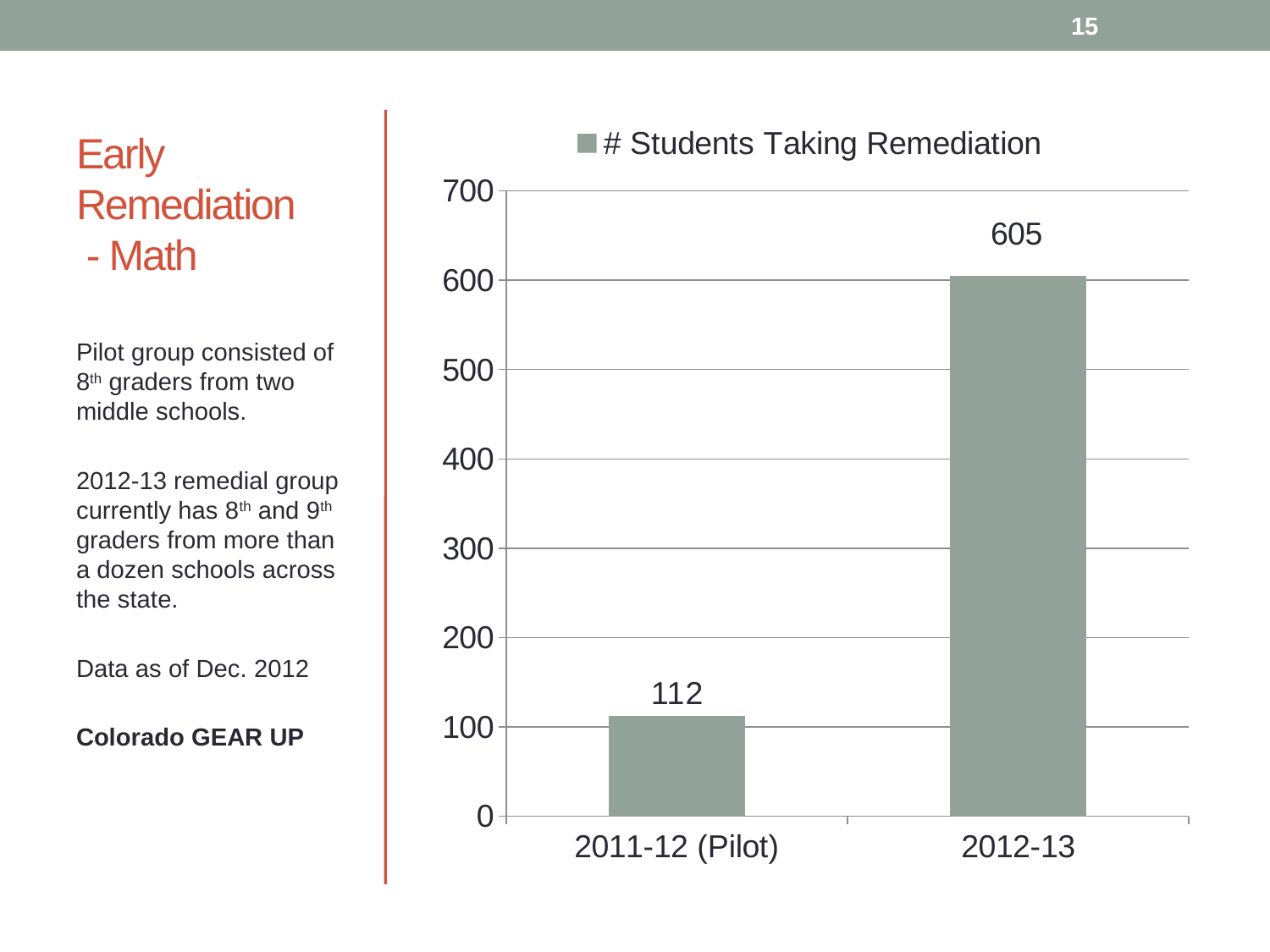
What is the number of students taking remediation for 2011-12 (Pilot)? 112 Which category has the highest number of students taking remediation? 2012-13 Is the value for 2011-12 (Pilot) greater or less than 200? less How many series does the chart legend list? 1 What is the number of students taking remediation for 2012-13? 605 Which is larger: the value for 2011-12 (Pilot) or the value for 2012-13? 2012-13 What is the legend entry shown above the chart? # Students Taking Remediation What is the difference in students taking remediation between 2012-13 and 2011-12 (Pilot)? 493 Which category has the lowest number of students taking remediation? 2011-12 (Pilot) How many categories are shown on the x axis of the chart? 2 Is the value for 2012-13 greater or less than 500? greater What kind of chart is shown on the slide? bar chart